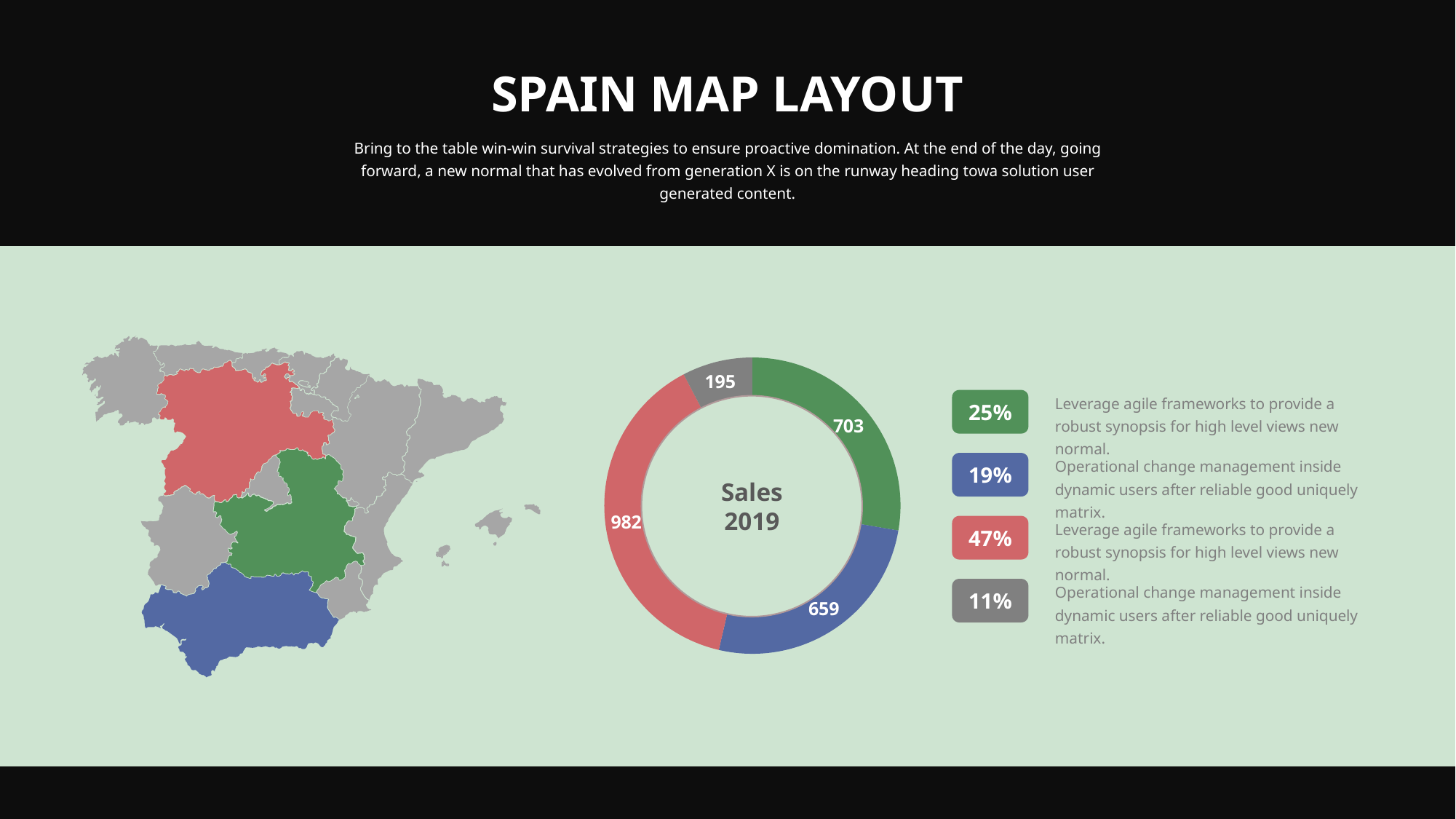
How many slices does the doughnut chart have? 4 What value is shown on the green slice of the doughnut chart? 703 What value is shown on the red slice of the doughnut chart? 982 What percentage is shown in the red box to the right of the doughnut chart? 47% What value is shown on the grey slice of the doughnut chart? 195 What value is shown on the blue slice of the doughnut chart? 659 Which slice of the doughnut chart has the largest value? Red (982) What is the difference between the red slice value and the green slice value in the doughnut chart? 279 Which slice of the doughnut chart has the smallest value? Grey (195) Which is larger in the doughnut chart, the green slice value or the blue slice value? Green (703) What type of chart is shown on the slide? Doughnut chart What is the title shown in the centre of the doughnut chart? Sales 2019